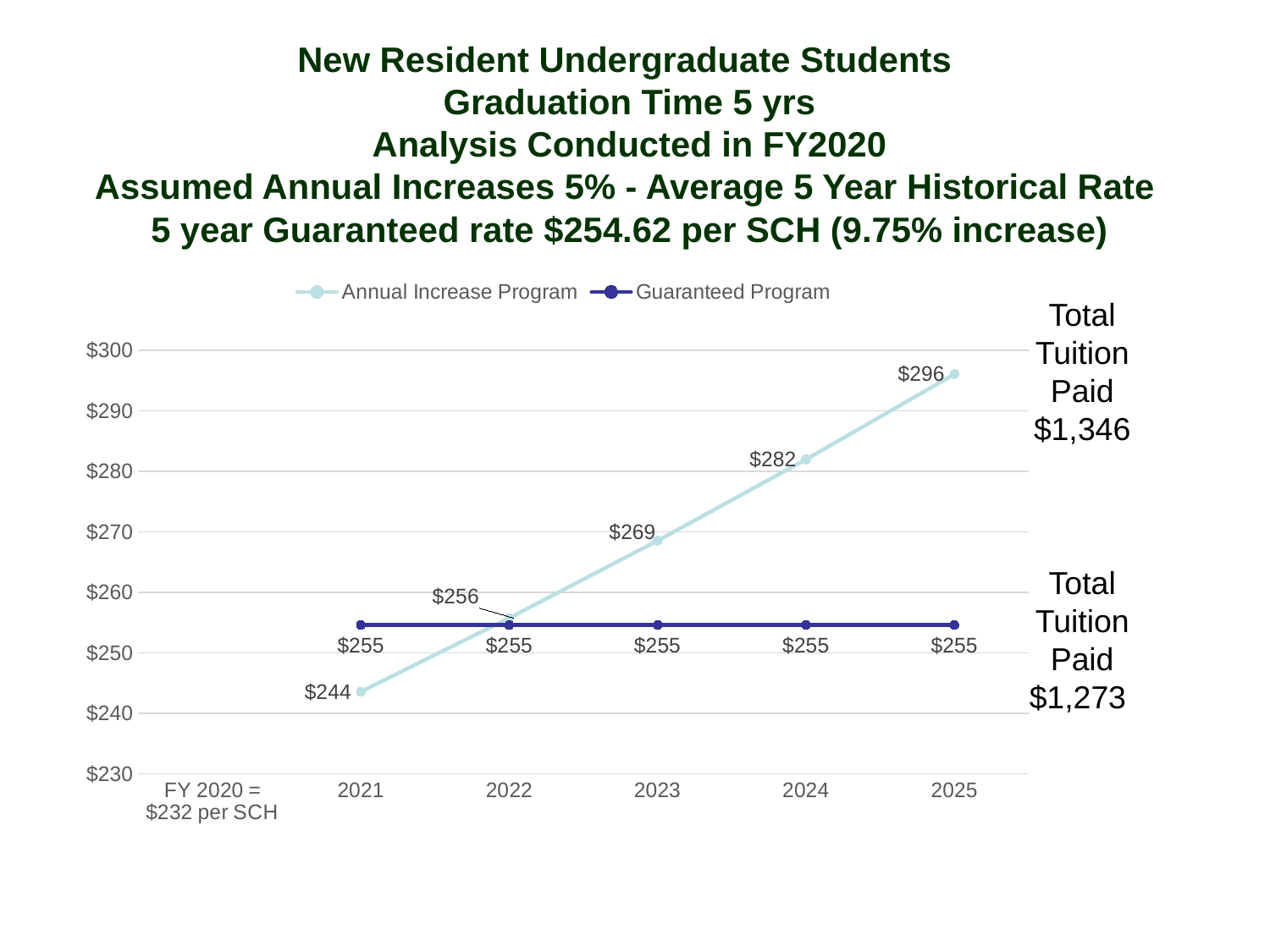
Does the Annual Increase Program line rise or fall from 2021 to 2025? rise What is the value for the Annual Increase Program in 2025? $296 How many series does the legend list? 2 What is the value for the Guaranteed Program in 2023? $255 What is the value for the Annual Increase Program in 2023? $269 What kind of chart is shown on the slide? line chart In which year is the Annual Increase Program value lowest? 2021 What is the value for the Annual Increase Program in 2021? $244 Which is larger in 2021, the Annual Increase Program value or the Guaranteed Program value? Guaranteed Program In which year is the Annual Increase Program value highest? 2025 What is the difference between the Annual Increase Program and the Guaranteed Program values in 2025? $41 Is the value for the Annual Increase Program in 2024 greater or less than $280? greater